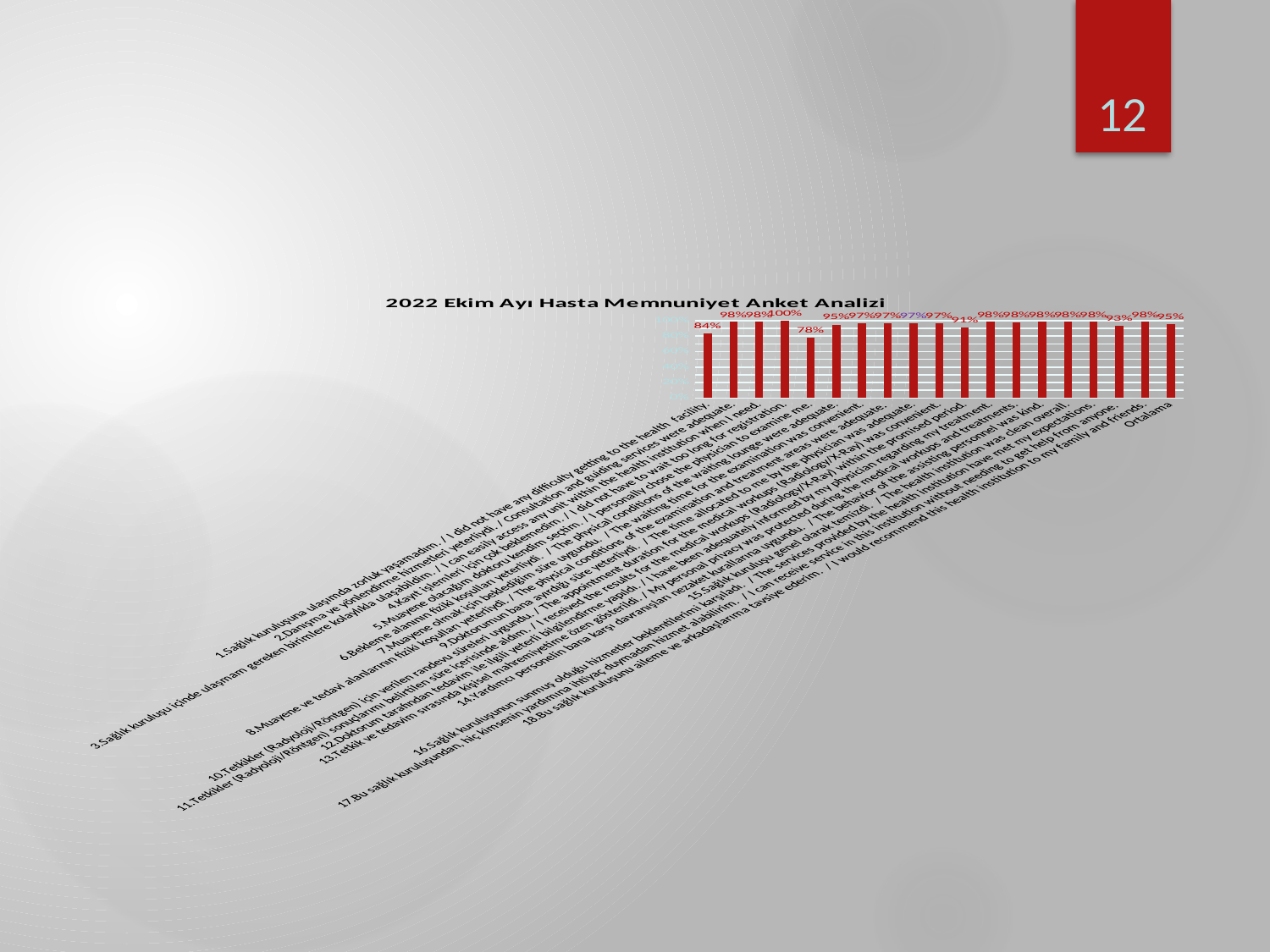
Which item has the lowest value in the chart? 5.Muayene olacağım doktoru kendim seçtim (78%) What is the value of the Ortalama bar? 95% What is the title of the chart? 2022 Ekim Ayı Hasta Memnuniyet Anket Analizi What is the value of the bar for item 11 (11.Tetkikler (Radyoloji/Röntgen) sonuçlarımı belirtilen süre içerisinde aldım)? 91% Which item has the highest value in the chart? 4.Kayıt işlemleri için çok beklemedim (100%) How many bars are plotted in the chart? 19 What is the value of the bar for item 17 (17.Bu sağlık kuruluşundan, hiç kimsenin yardımına ihtiyaç duymadan hizmet alabilirim)? 93% Which is larger: the value for item 1 (84%) or the value for item 5 (78%)? item 1 (84%) What is the value of the first bar (1.Sağlık kuruluşuna ulaşımda zorluk yaşamadım)? 84% What kind of chart is shown on the slide? bar chart What is the value of the bar for item 5 (5.Muayene olacağım doktoru kendim seçtim)? 78% What is the difference between the highest value (100%) and the lowest value (78%)? 22 percentage points